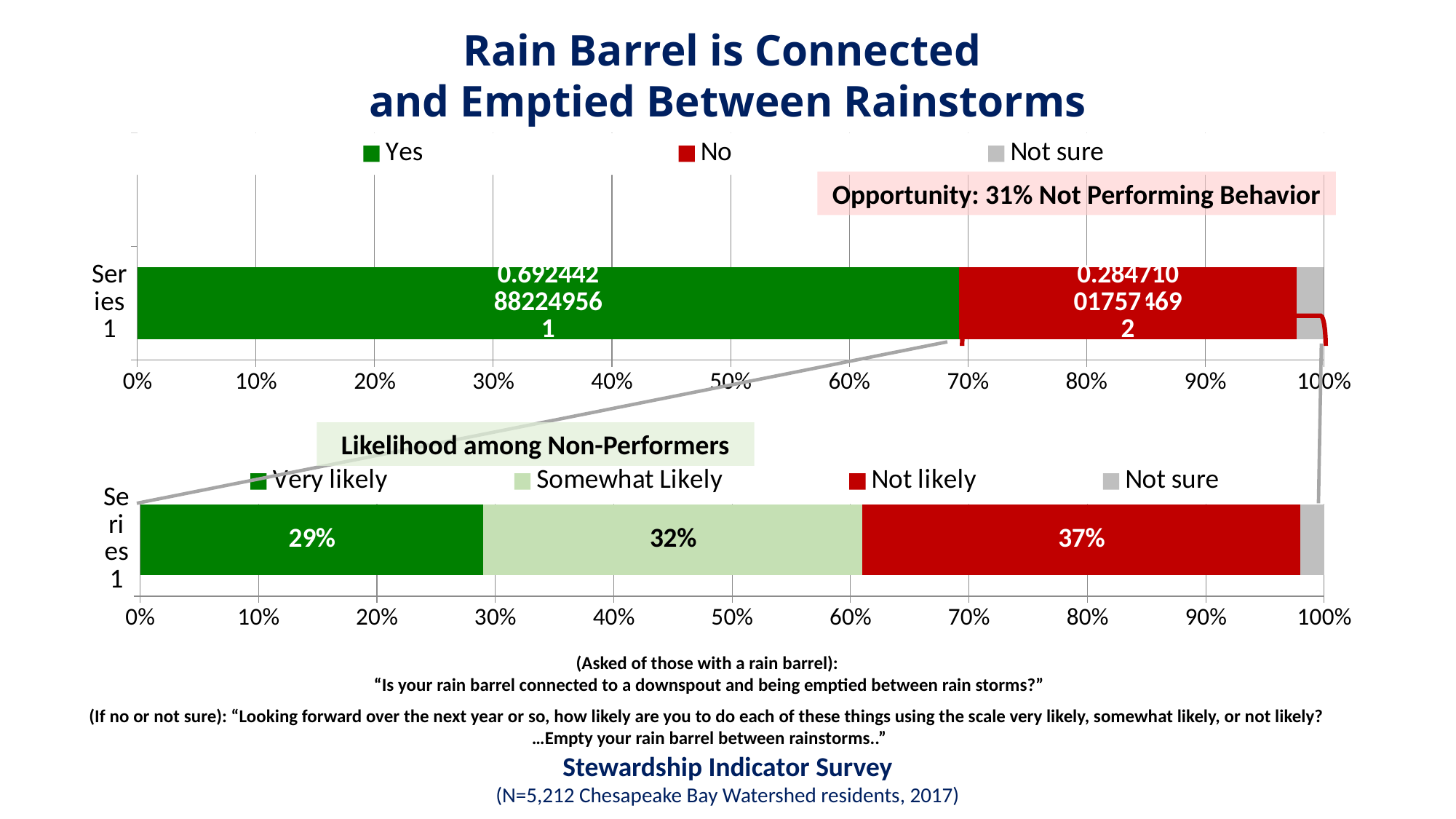
In the bottom chart (Likelihood among Non-Performers), what is the value for Somewhat Likely? 32% In the bottom chart (Likelihood among Non-Performers), which is larger, Somewhat Likely or Very likely? Somewhat Likely What kind of chart is the top chart on the slide? Stacked bar chart In the top chart, is the value for Yes greater or less than 60%? greater In the bottom chart (Likelihood among Non-Performers), what is the difference between Not likely and Very likely? 8 percentage points According to the callout on the top chart, what percentage is not performing the behavior? 31% In the bottom chart (Likelihood among Non-Performers), what is the value for Not likely? 37% How many series does the legend of the top chart list? 3 In the bottom chart (Likelihood among Non-Performers), what is the value for Very likely? 29% In the top chart, is the value for No greater or less than 20%? greater In the bottom chart (Likelihood among Non-Performers), which segment has the highest value? Not likely How many series does the legend of the bottom chart (Likelihood among Non-Performers) list? 4